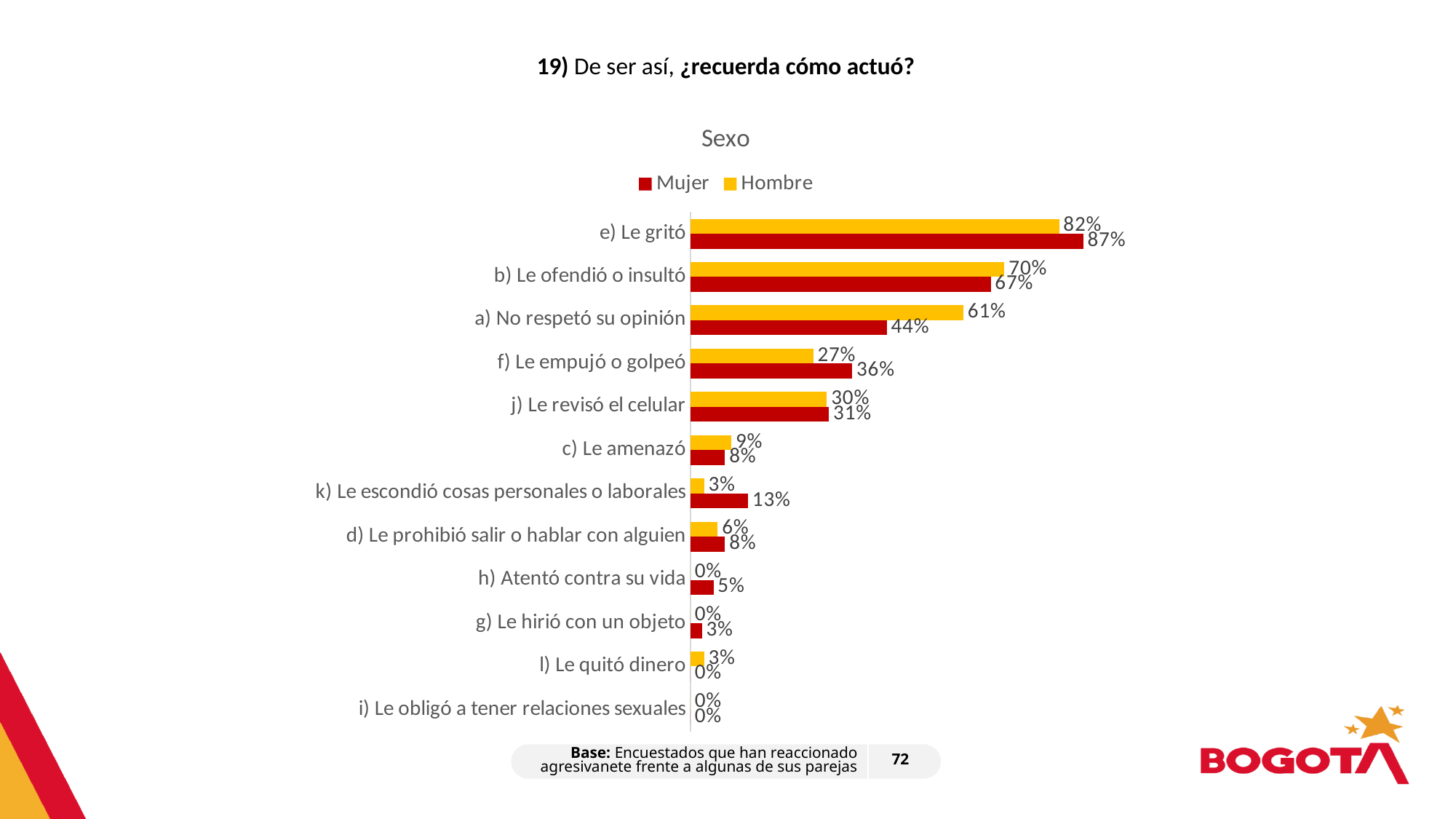
What is the value for Mujer for "k) Le escondió cosas personales o laborales"? 13% What is the difference between the Hombre and Mujer values for "a) No respetó su opinión"? 17% What is the value for Hombre for "a) No respetó su opinión"? 61% What is the value for Mujer for "e) Le gritó"? 87% For "b) Le ofendió o insultó", which is larger, the Mujer value or the Hombre value? Hombre For "h) Atentó contra su vida", which is larger, the Mujer value or the Hombre value? Mujer How many series does the legend list? 2 What kind of chart is shown on the slide? Bar chart Which category has the highest value for Hombre? e) Le gritó What is the difference between the Mujer and Hombre values for "f) Le empujó o golpeó"? 9% How many categories are shown in the chart? 12 Which colour represents the Mujer series in the chart? Red